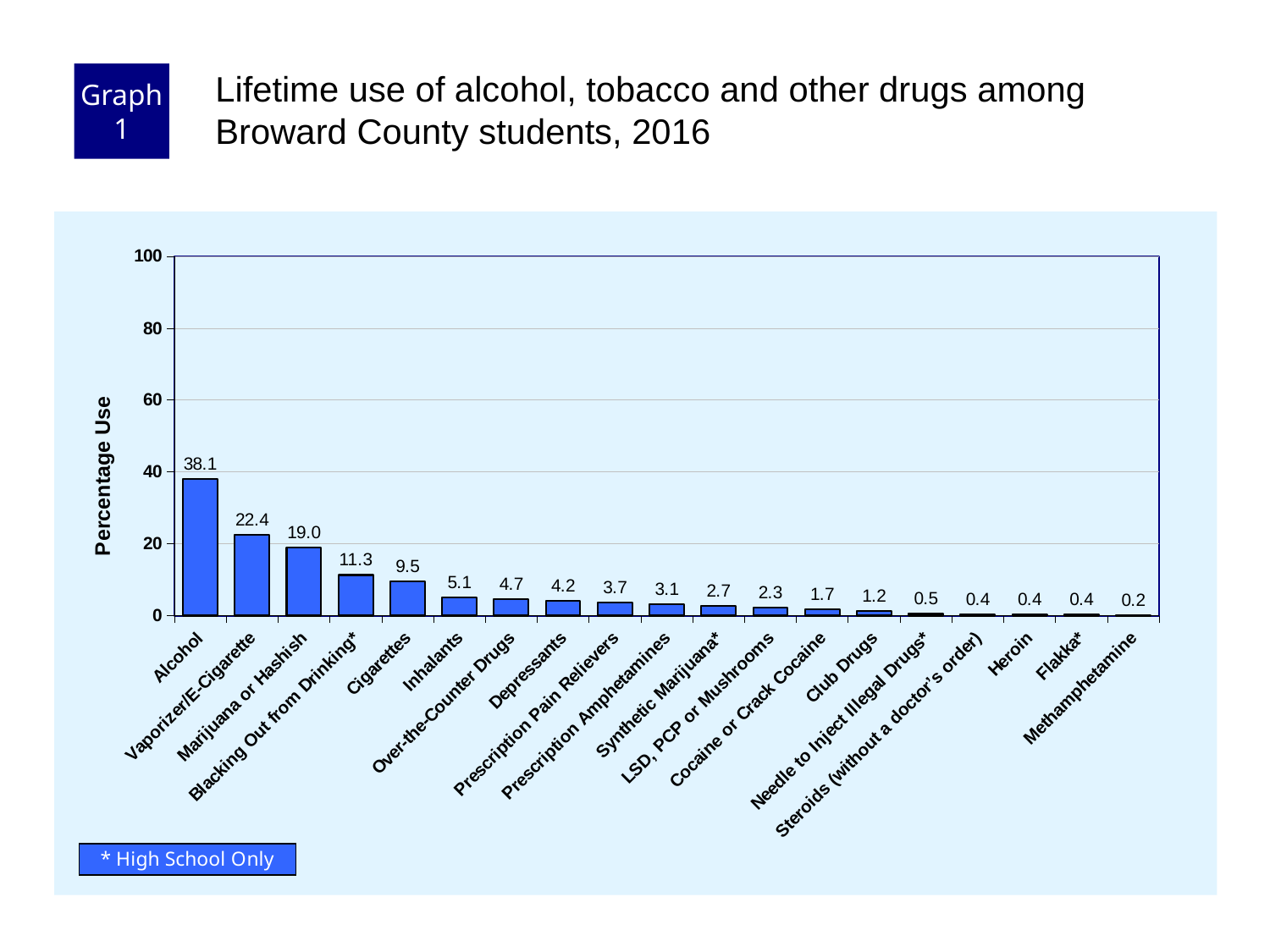
Is the value for Vaporizer/E-Cigarette greater or less than 20? greater What is the percentage use for Inhalants? 5.1 What is the label of the y axis? Percentage Use What is the percentage use for Cigarettes? 9.5 What is the percentage use for Alcohol? 38.1 What kind of chart is shown on the slide? Bar chart How many categories are shown on the x axis? 19 Which has a higher percentage use, Blacking Out from Drinking* or Cigarettes? Blacking Out from Drinking* What is the percentage use for Vaporizer/E-Cigarette? 22.4 Which category has the lowest percentage use? Methamphetamine Which category has the highest percentage use? Alcohol What is the difference in percentage use between Alcohol and Marijuana or Hashish? 19.1